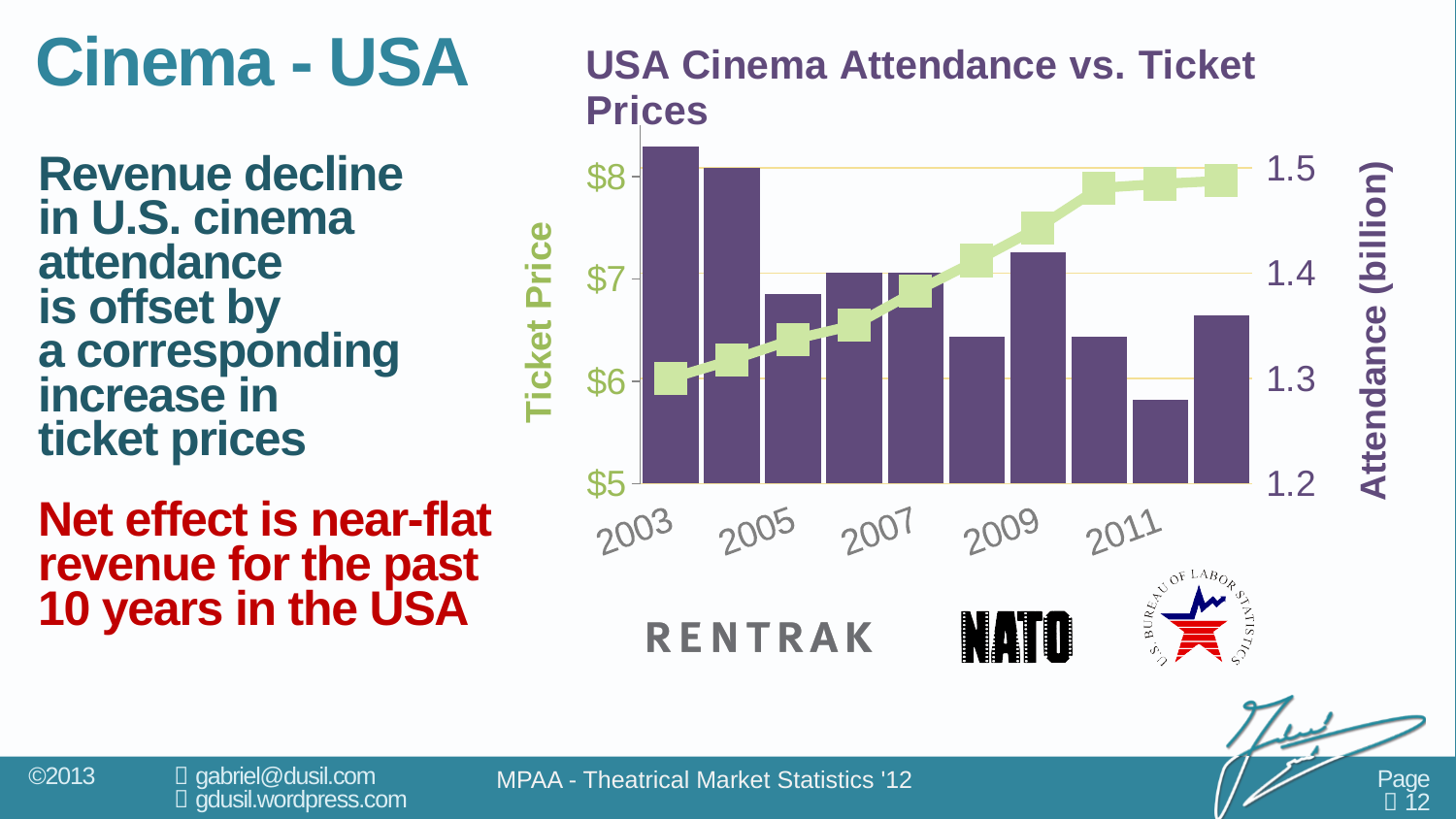
What kind of chart is used to show the data on the slide? A bar chart combined with a line Which year has the higher attendance bar, 2003 or 2011? 2003 Is the ticket price for 2005 greater or less than $7? less Which year has the tallest attendance bar in the chart? 2003 How many bars are plotted in the chart? 10 Does the ticket price line rise or fall from 2003 to 2011? rise Is the ticket price for 2011 greater or less than $7? greater What is the label of the right-hand vertical axis of the chart? Attendance (billion) Is the ticket price for 2003 greater or less than $7? less What is the title of the chart? USA Cinema Attendance vs. Ticket Prices Which labelled year has the shortest attendance bar in the chart? 2011